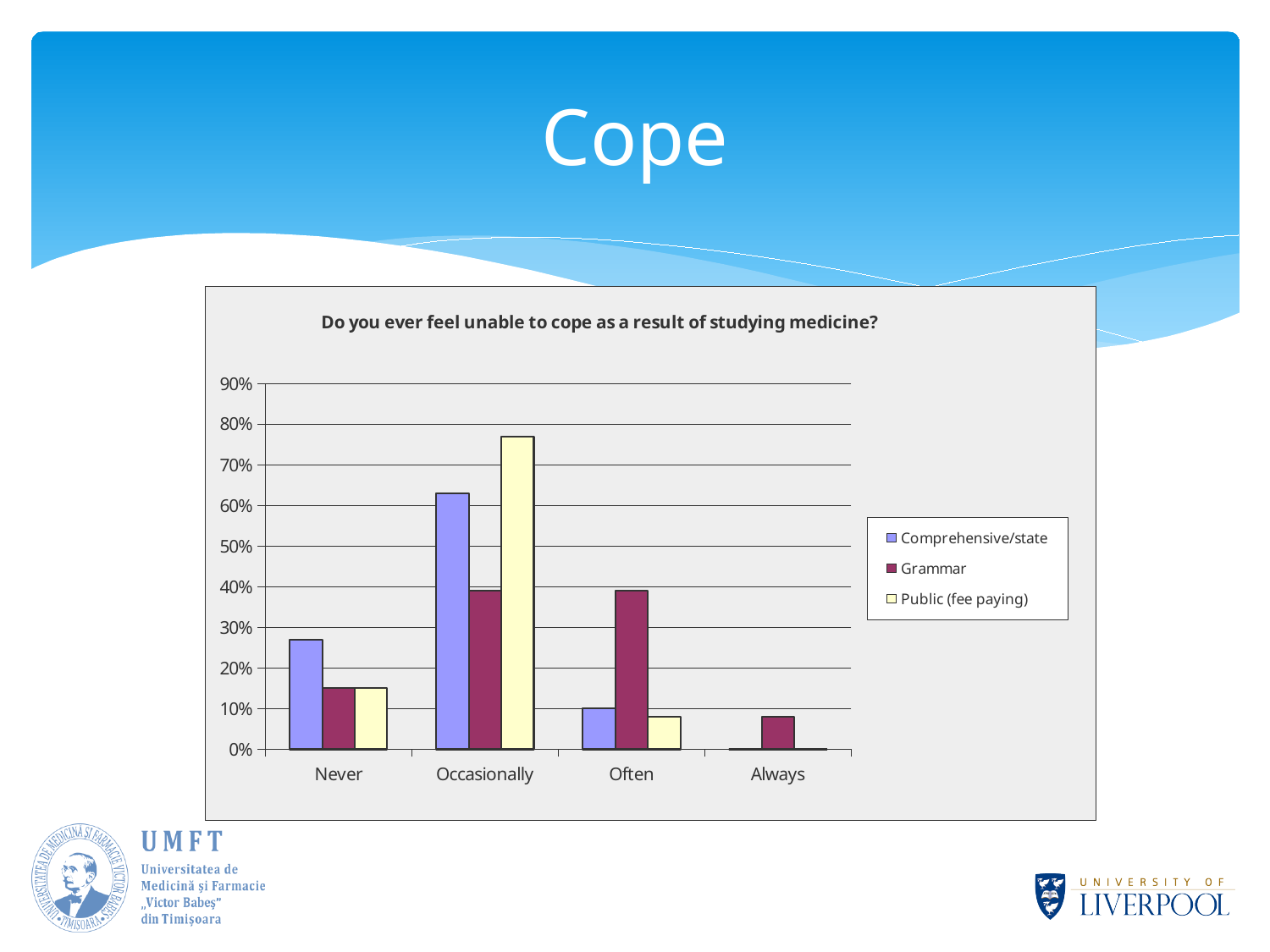
What is the title of the chart? Do you ever feel unable to cope as a result of studying medicine? Is the value for Comprehensive/state in the Never category greater or less than 30%? less Which series has the highest value in the Often category? Grammar What kind of chart is shown on the slide? bar chart How many series does the legend list? 3 Which response category has the highest value for the Public (fee paying) series? Occasionally Which series has the highest value in the Occasionally category? Public (fee paying) How many response categories are shown on the x axis? 4 Is the value for Public (fee paying) in the Occasionally category greater or less than 70%? greater In the Occasionally category, which is larger: the Comprehensive/state value or the Grammar value? Comprehensive/state Is the value for Grammar in the Always category greater or less than 10%? less